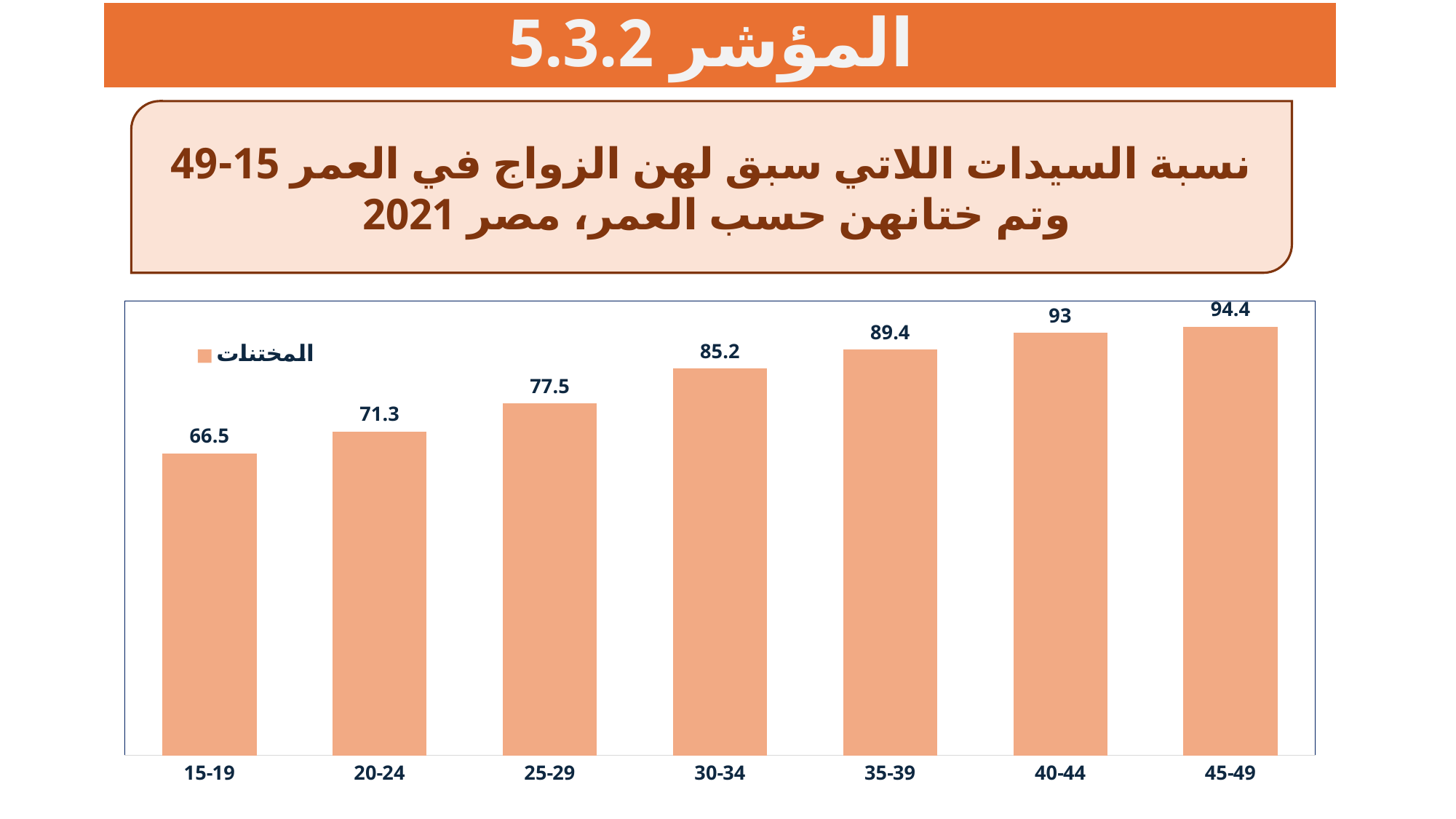
How many age groups are shown on the x axis? 7 How many series does the legend list? 1 Which is larger, the value for 35-39 or the value for 30-34? 35-39 Which age group has the lowest value? 15-19 What kind of chart is shown on the slide? bar chart What is the difference between the values for 25-29 and 20-24? 6.2 Which age group has the highest value? 45-49 What is the value for the 40-44 age group? 93 Do the values rise or fall as age increases along the x axis? rise What is the value for the 30-34 age group? 85.2 What is the value for the 15-19 age group? 66.5 What is the difference between the values for 45-49 and 15-19? 27.9